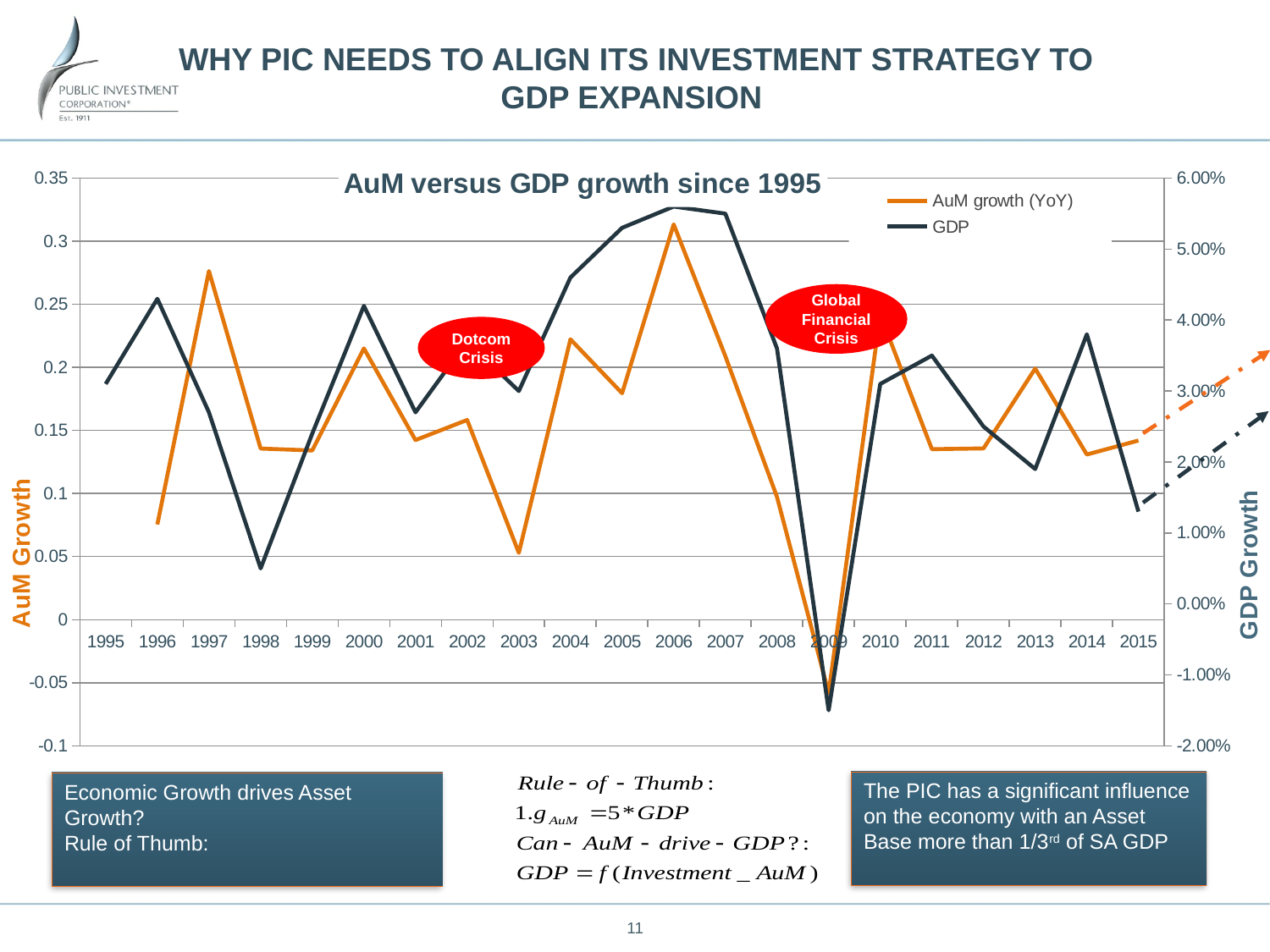
Does the AuM growth (YoY) series rise or fall between 2006 and 2009? fall Is the AuM growth (YoY) value for 1996 greater or less than 0.1? less Is the AuM growth (YoY) value for 2006 greater or less than 0.3? greater In which year does the AuM growth (YoY) series reach its lowest value? 2009 In which year does the AuM growth (YoY) series reach its highest value? 2006 Which two crises are labelled with red ovals on the chart? Dotcom Crisis and Global Financial Crisis Is the GDP value for 2009 greater or less than -1.00%? less In which year does the GDP series reach its lowest value? 2009 How many years are plotted along the x axis of the chart? 21 How many series does the chart legend list? 2 What is the title of the chart? AuM versus GDP growth since 1995 What kind of chart is shown on the slide? line chart